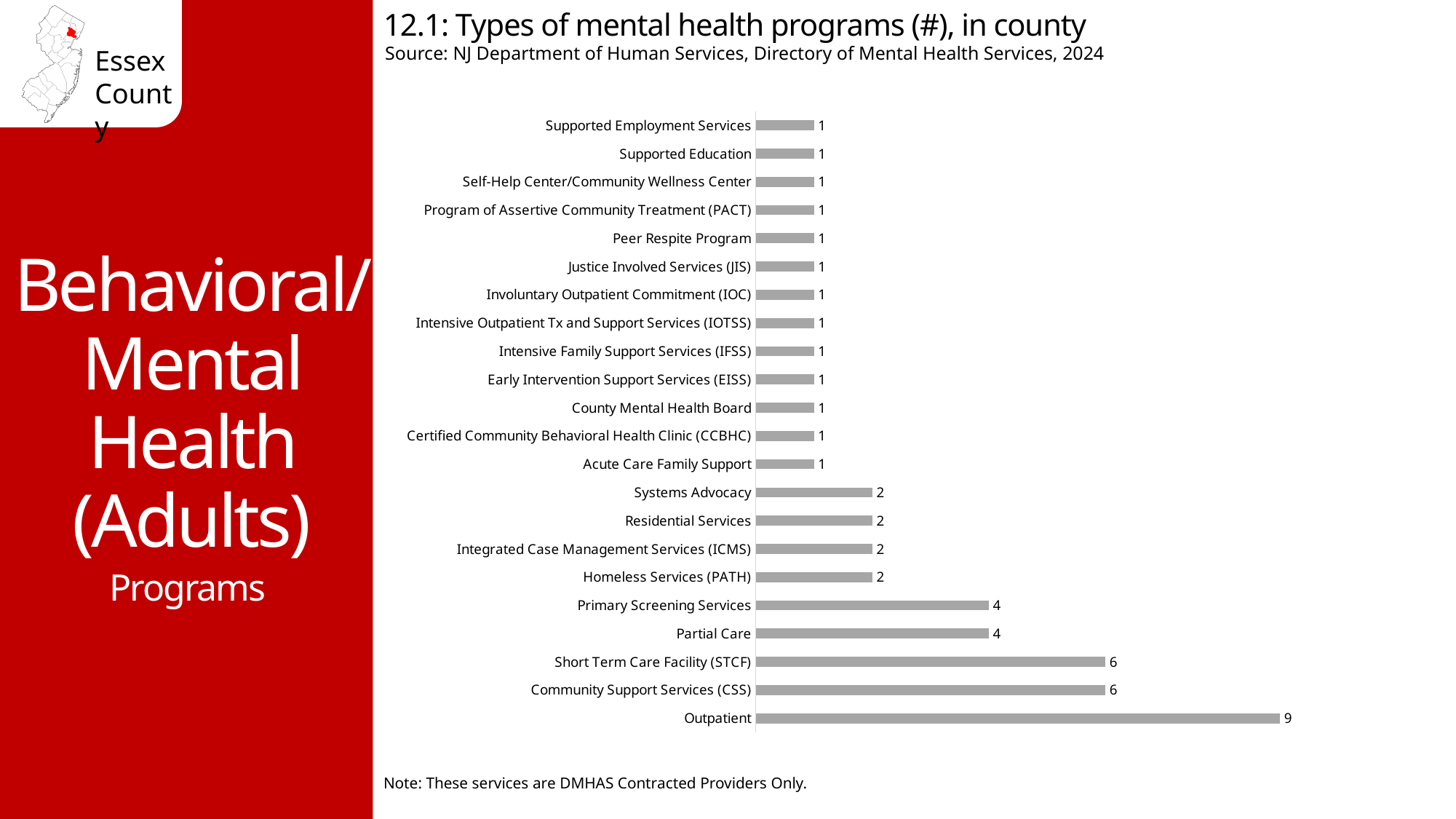
Which has more programs, Residential Services or Peer Respite Program? Residential Services Which has more programs, Short Term Care Facility (STCF) or Partial Care? Short Term Care Facility (STCF) What is the number of Outpatient programs shown in the chart? 9 What value is shown for Homeless Services (PATH)? 2 What is the difference between Primary Screening Services and Systems Advocacy? 2 What is the title of the chart? 12.1: Types of mental health programs (#), in county What is the difference between the Outpatient count and the Community Support Services (CSS) count? 3 What value is shown for Partial Care? 4 Which type of mental health program has the highest count? Outpatient How many program types are listed in the chart? 22 What kind of chart is used on this slide? Bar chart How many Short Term Care Facility (STCF) programs are shown? 6